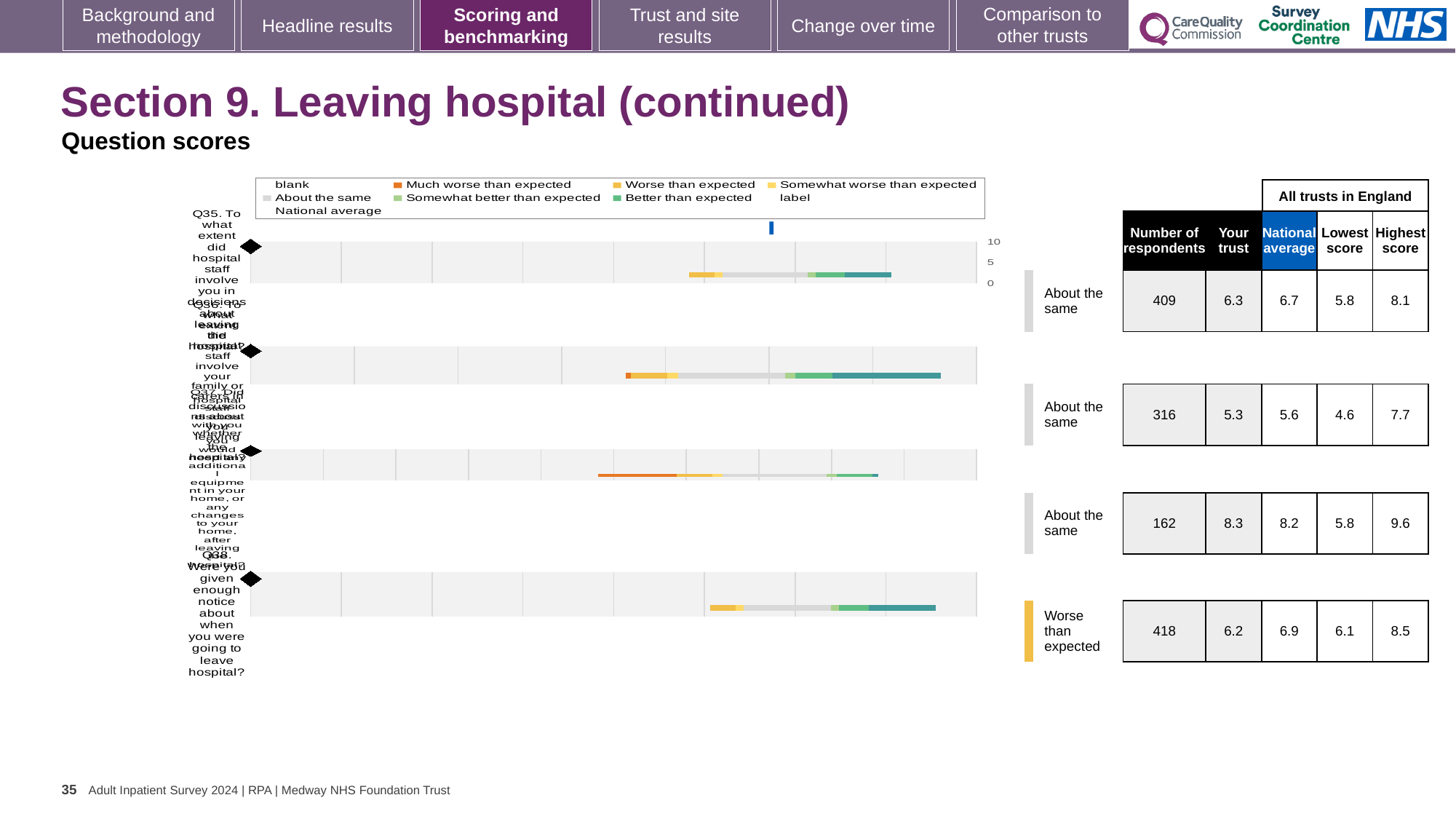
Which question has the highest 'Your trust' score? Q37 How many respondents are listed for Q37 (the third row)? 162 What kind of chart is used to show the question scores on this slide? bar chart What is the national average score for Q36 (the second row)? 5.6 For Q38, how much higher is the national average than the 'Your trust' score? 0.7 For Q37, which is larger: the 'Your trust' score or the national average? Your trust What is the 'Your trust' score for Q35 (the first row)? 6.3 Which question has the lowest 'Your trust' score? Q36 Which benchmark category is Q38 (the last row) rated as? Worse than expected How many questions (rows) are plotted in the chart? 4 How many of the questions are rated 'About the same'? 3 What is the highest score across all trusts in England for Q38 (the last row)? 8.5